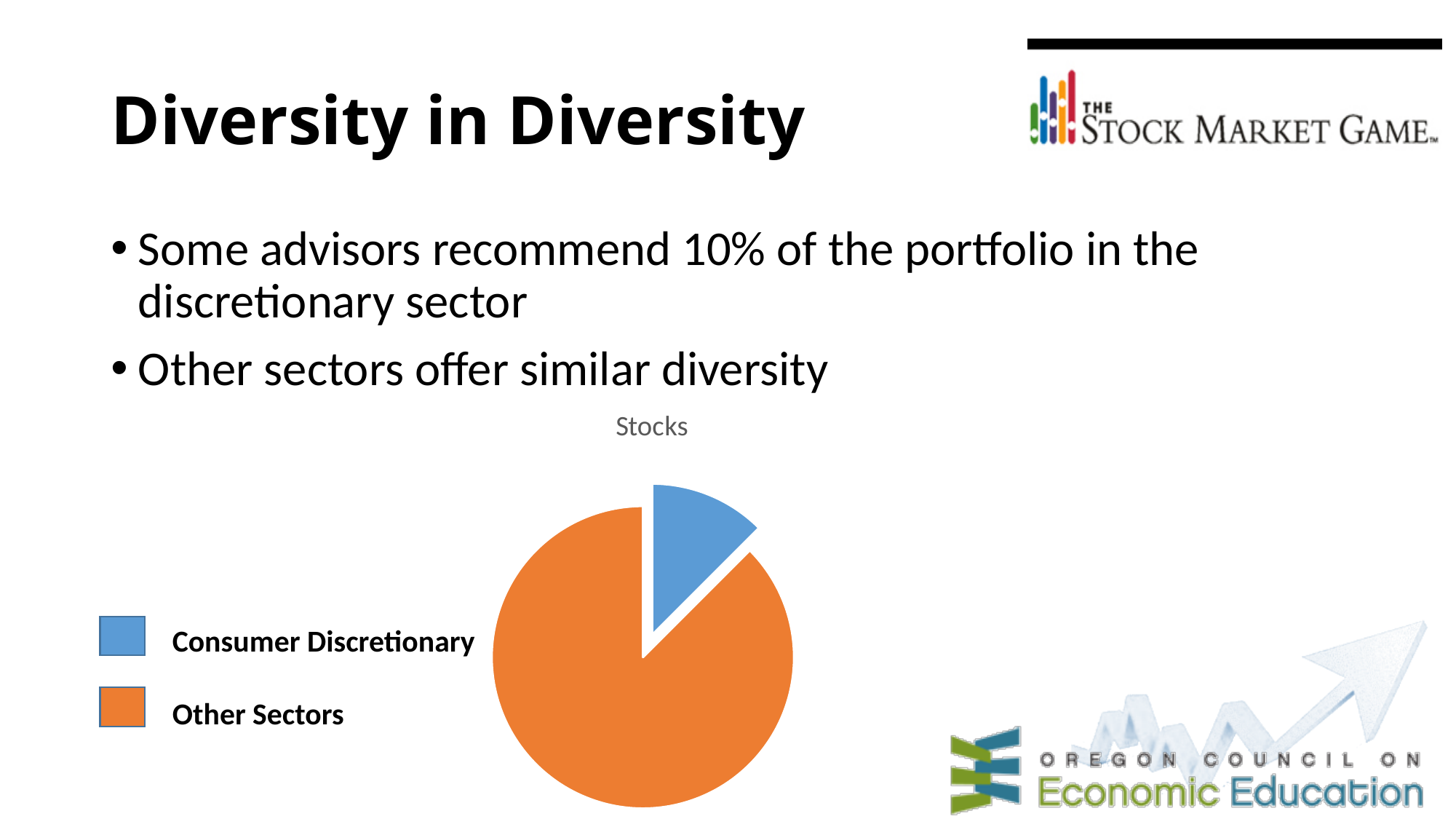
Which is larger in the pie chart, Consumer Discretionary or Other Sectors? Other Sectors What colour is the Consumer Discretionary slice in the pie chart? blue How many entries does the legend of the pie chart list? 2 Which slice of the pie chart is pulled out (exploded) from the rest of the pie? Consumer Discretionary How many slices does the pie chart have? 2 Which slice of the pie chart is the smallest? Consumer Discretionary What kind of chart is shown on the slide? pie chart Which slice of the pie chart is the largest? Other Sectors What is the title of the pie chart? Stocks